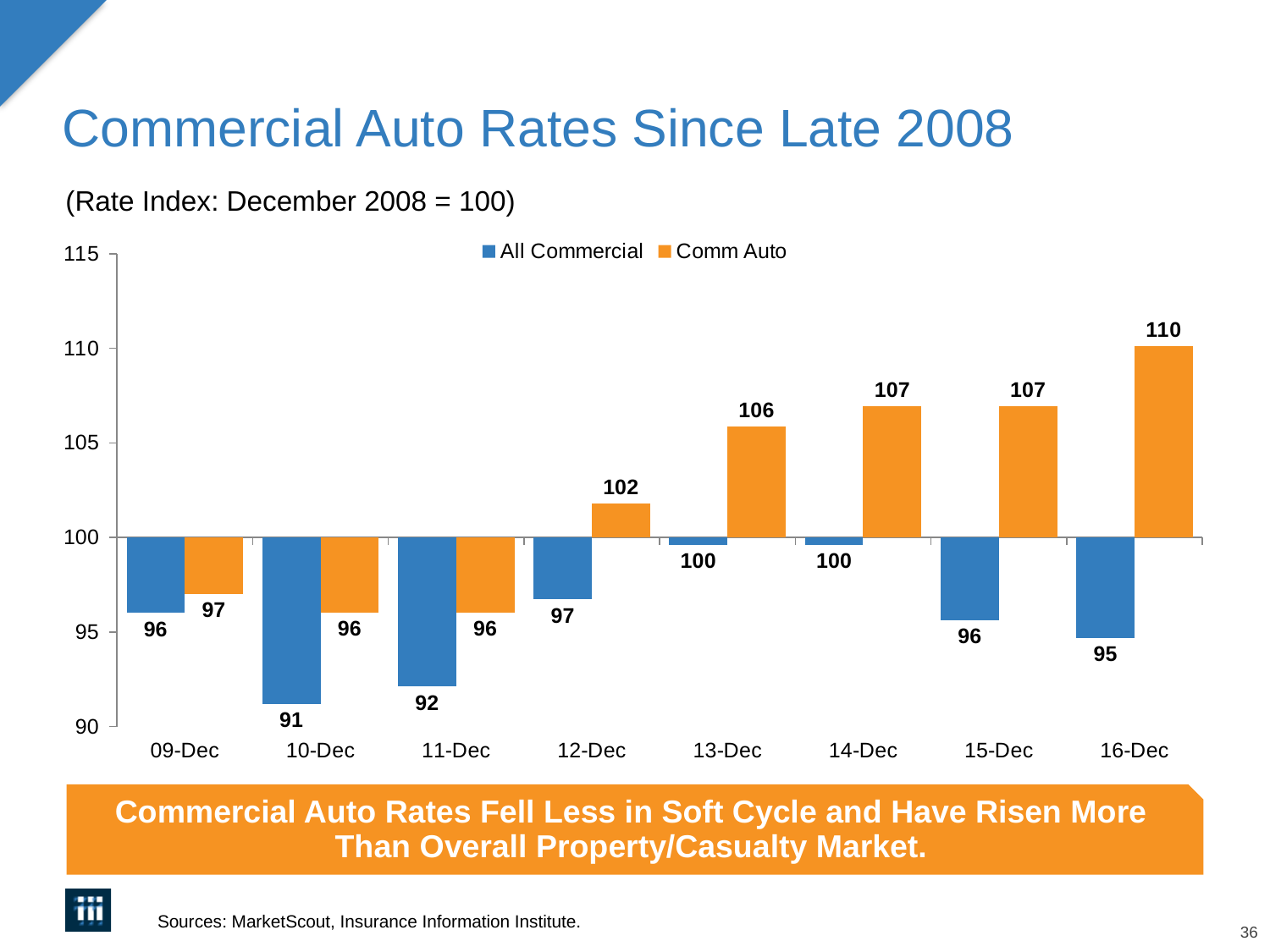
Does the Comm Auto series generally rise or fall from 09-Dec to 16-Dec? Rise What is the All Commercial value for 10-Dec? 91 What is the Comm Auto value for 12-Dec? 102 What is the difference between the Comm Auto values for 15-Dec and 12-Dec? 5 What is the difference between the Comm Auto and All Commercial values for 16-Dec? 15 How many periods are shown on the x axis? 8 Which is larger for 11-Dec, the All Commercial value or the Comm Auto value? Comm Auto What kind of chart is shown on the slide? Bar chart Which period has the highest Comm Auto value? 16-Dec Which period has the lowest All Commercial value? 10-Dec How many series does the legend list? 2 What is the Comm Auto value for 16-Dec? 110